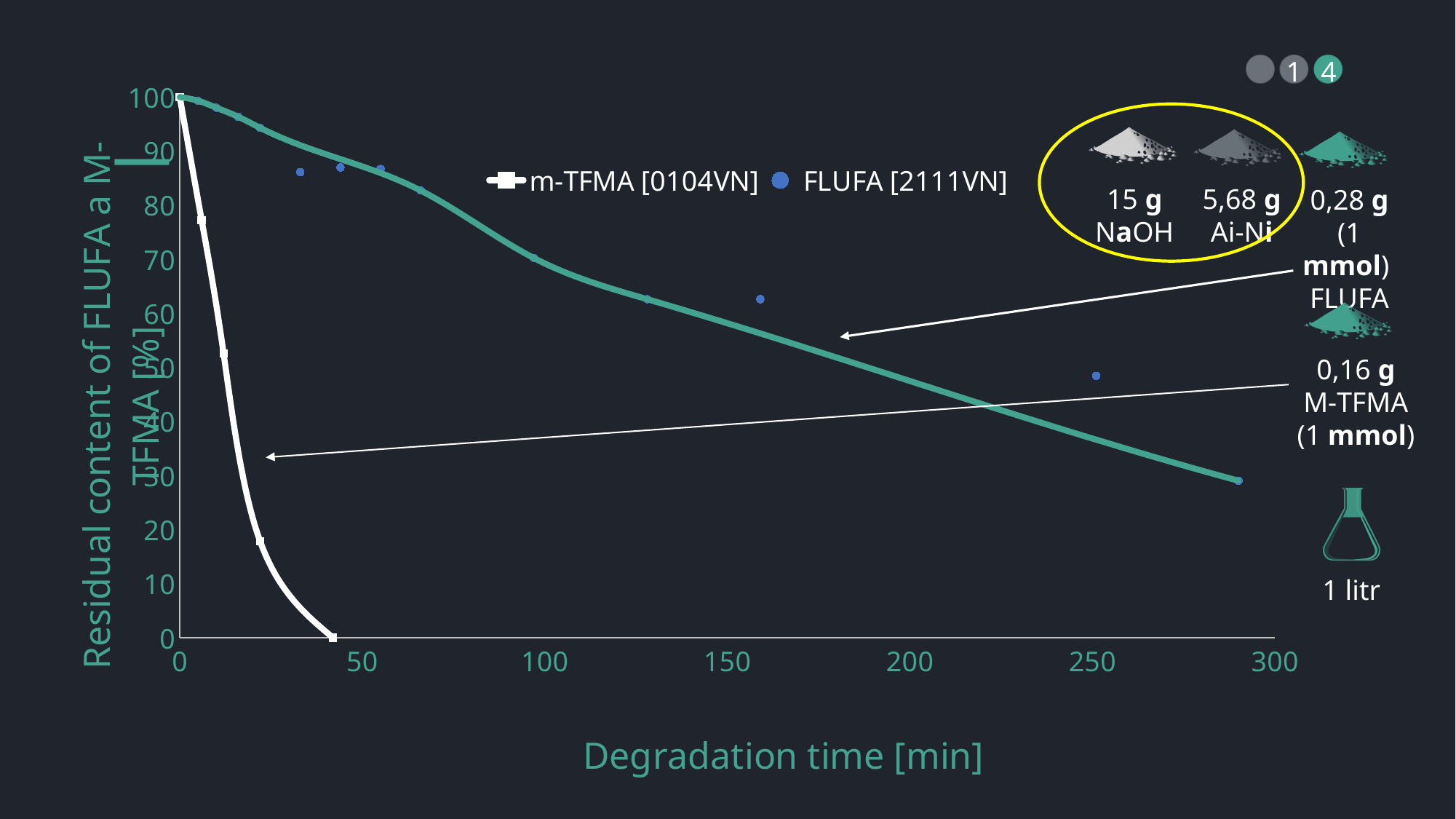
Which series drops to 0% residual content first, m-TFMA [0104VN] or FLUFA [2111VN]? m-TFMA [0104VN] Is the residual content of FLUFA [2111VN] at about 160 min greater or less than 50? greater What are the two series named in the legend? m-TFMA [0104VN] and FLUFA [2111VN] Do the values for FLUFA [2111VN] rise or fall as degradation time increases? fall What is the residual content of m-TFMA [0104VN] at 0 min? 100 Do the values for m-TFMA [0104VN] rise or fall as degradation time increases? fall What is the title of the x axis? Degradation time [min] What kind of chart is shown on the slide? line chart At around 40 min, which series has the higher residual content, m-TFMA [0104VN] or FLUFA [2111VN]? FLUFA [2111VN] How many series does the chart legend list? 2